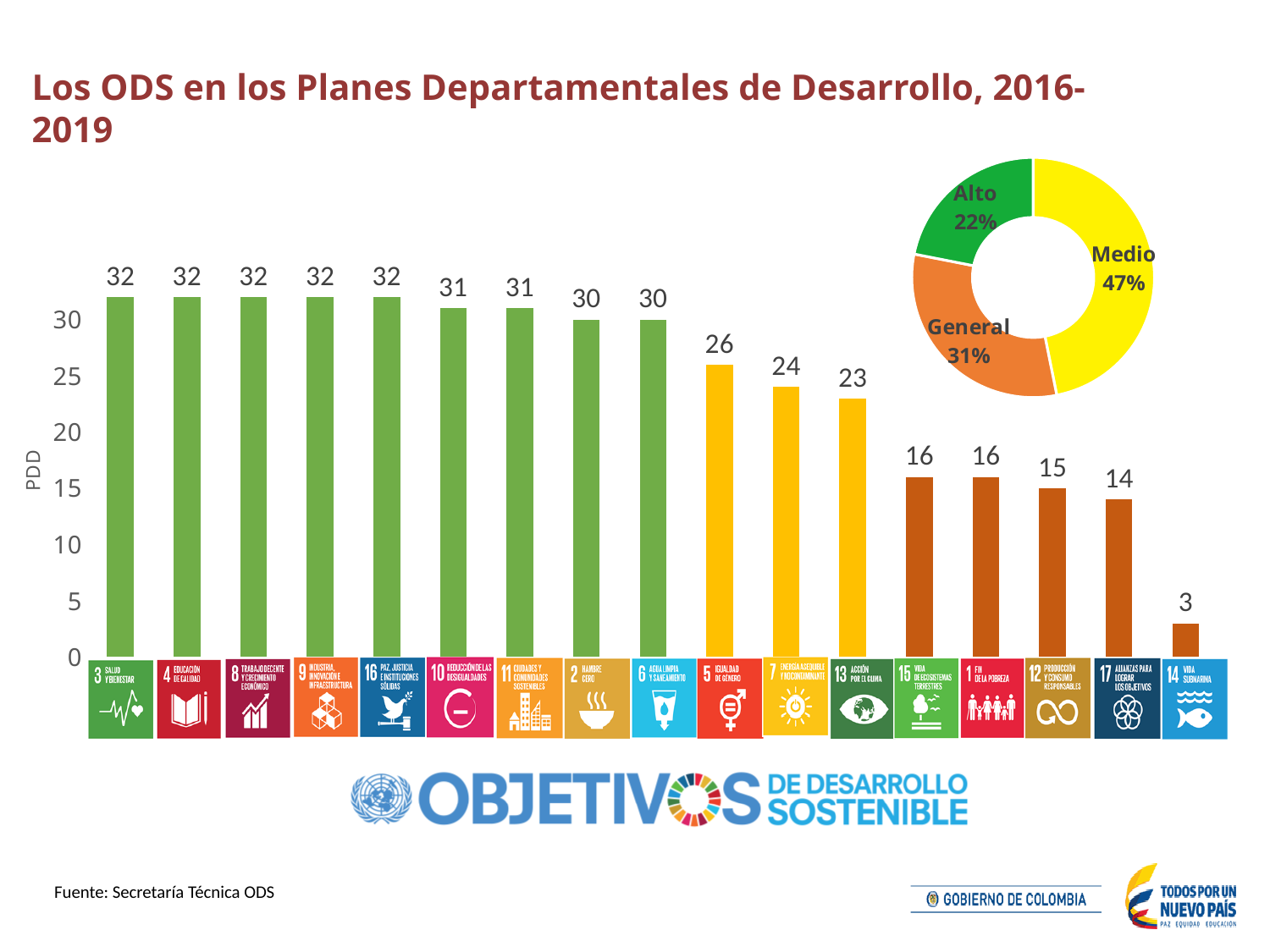
In the bar chart, which is larger: the value for ODS 17 Alianzas para lograr los Objetivos or the value for ODS 12 Producción y Consumo Responsables? ODS 12 Producción y Consumo Responsables What kind of chart is the large chart on the left of the slide? Bar chart In the bar chart, how many ODS categories are plotted? 17 In the bar chart, what is the value for ODS 1 Fin de la Pobreza? 16 In the bar chart, what is the difference between the values for ODS 7 Energía Asequible and ODS 13 Acción por el Clima? 1 In the donut chart, which category has the smallest share? Alto What is the label on the vertical axis of the bar chart? PDD In the bar chart, do the values rise or fall from left to right? Fall In the bar chart, which ODS has the lowest value? 14 Vida Submarina In the bar chart, what is the value for ODS 5 Igualdad de Género? 26 In the bar chart, what is the value for ODS 14 Vida Submarina? 3 In the donut chart, what share is labelled Medio? 47%